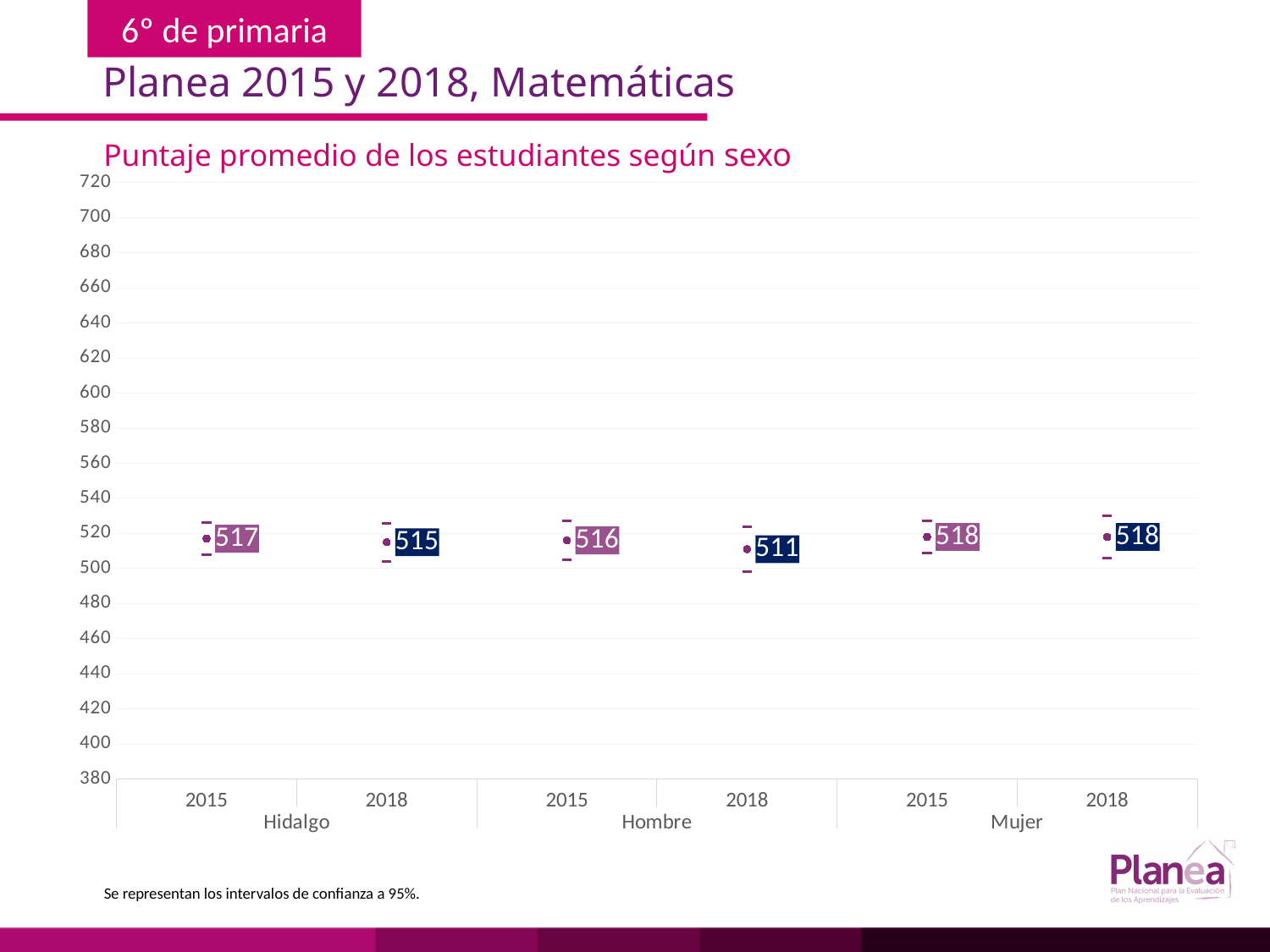
What is the difference between the Hombre score in 2015 and in 2018? 5 Is the value for Hombre in 2018 greater or less than 500? greater What is the average score for Mujer in 2015? 518 How many data points are plotted on the chart? 6 What is the average score for Hombre in 2018? 511 Which group and year has the lowest average score? Hombre 2018 What is the average score for Hidalgo in 2015? 517 Which is larger, the Hidalgo score in 2015 or the Hidalgo score in 2018? Hidalgo 2015 What is the average score for Hidalgo in 2018? 515 What is the title of the chart? Puntaje promedio de los estudiantes según sexo Did the Hombre score rise or fall from 2015 to 2018? fall What is the difference between the Mujer score and the Hombre score in 2018? 7